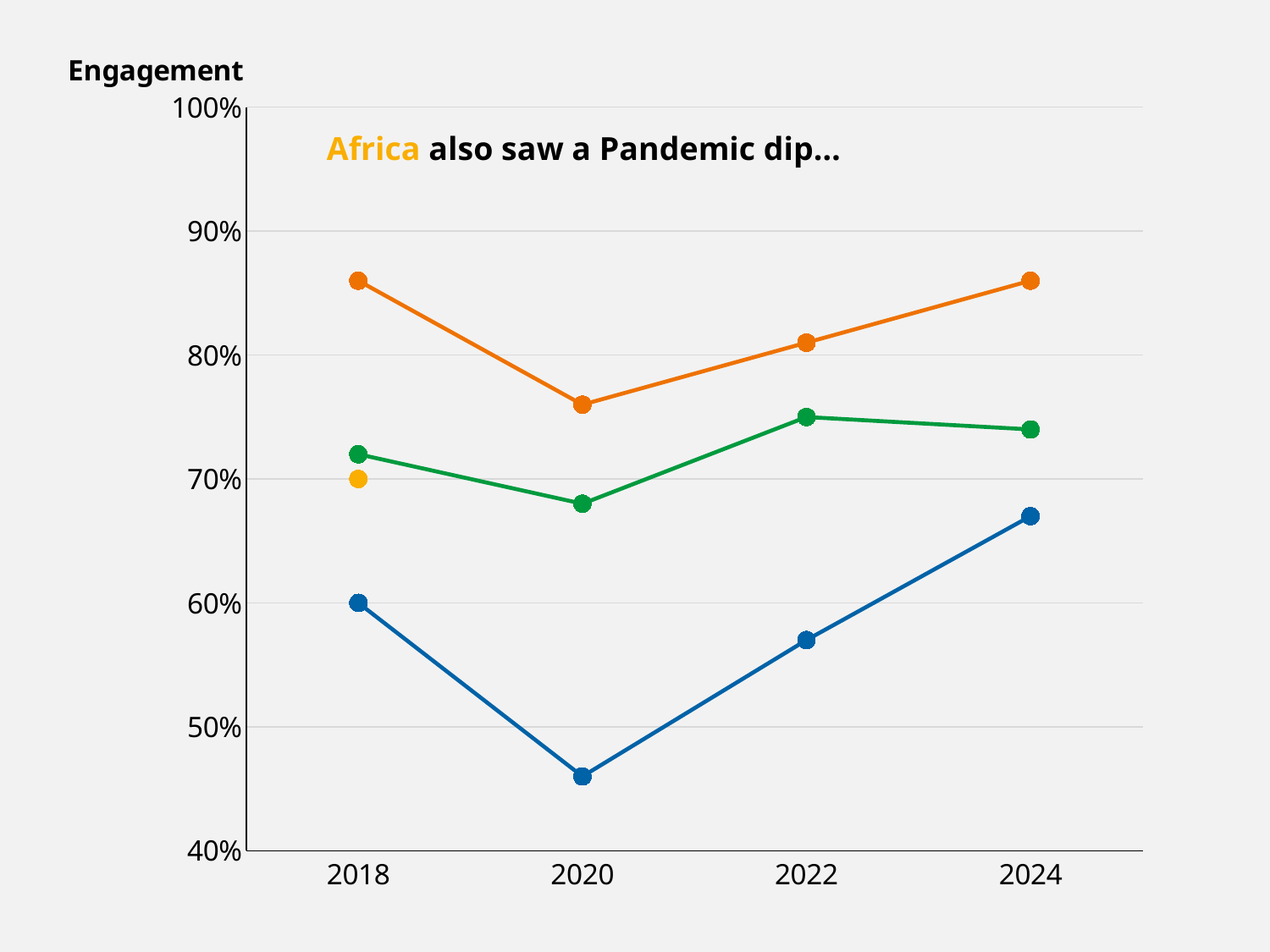
What is the value of the blue line in 2018? 60% What is the value of the yellow Africa point in 2018? 70% How many years are shown on the x axis? 4 Is the value of the orange line in 2020 greater or less than 70%? greater Is the value of the blue line in 2020 greater or less than 50%? less In 2022, which line has the higher value, the orange line or the green line? orange What kind of chart is shown on the slide? line chart In which year is the blue line at its lowest? 2020 Is the value of the orange line in 2018 greater or less than 80%? greater In which year is the blue line at its highest? 2024 What is the label on the y axis? Engagement Does the blue line rise or fall from 2020 to 2024? rise